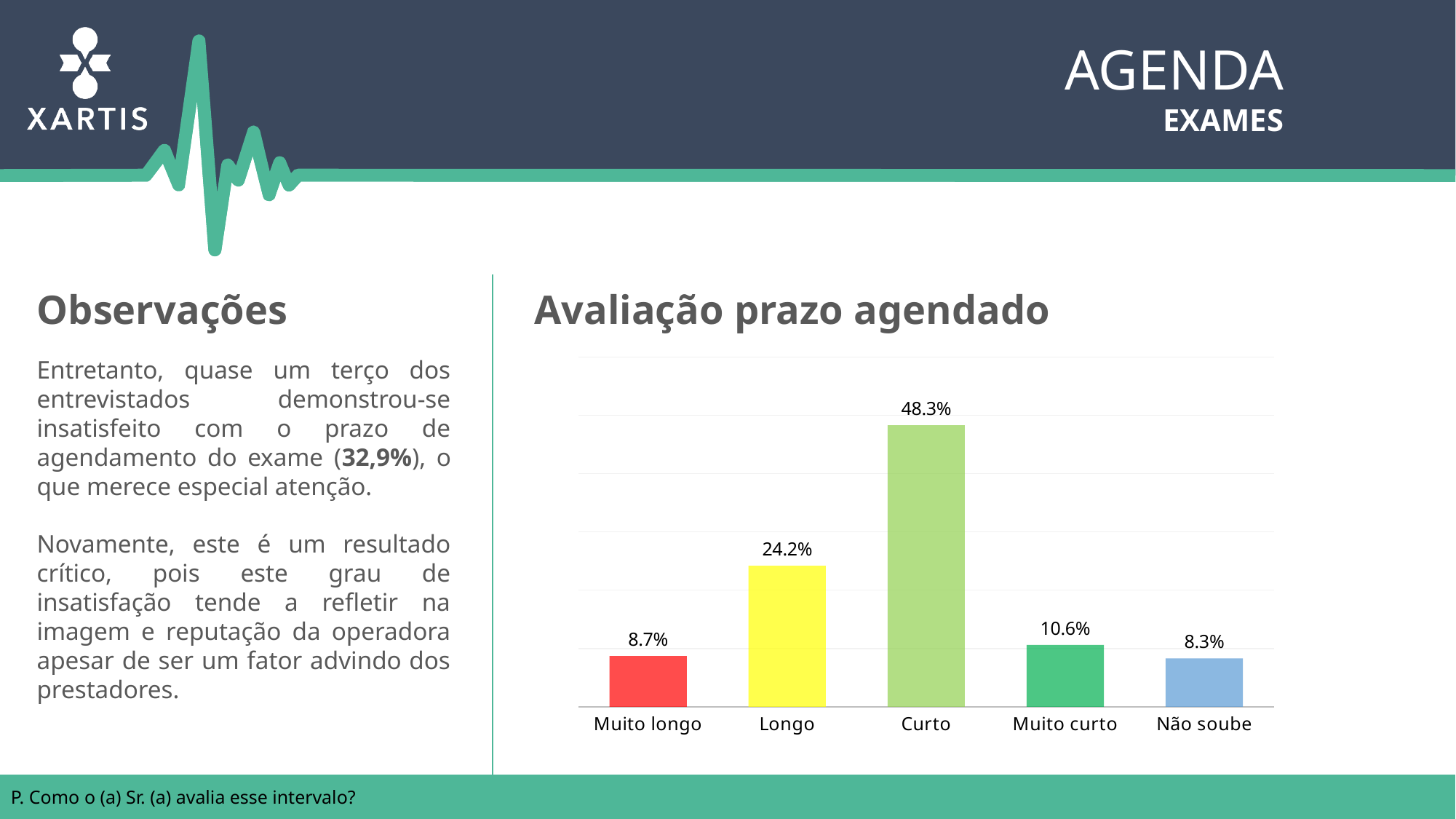
What is the difference between the values for Muito curto and Muito longo? 1.9% What is the value for Muito longo? 8.7% Which category has the highest value? Curto Which category has the lowest value? Não soube What is the value for Longo? 24.2% What is the value for Não soube? 8.3% What is the value for Curto? 48.3% What is the title of the chart? Avaliação prazo agendado What is the difference between the values for Curto and Longo? 24.1% What kind of chart is shown on the slide? Bar chart How many categories are shown in the chart? 5 Which is larger, the value for Longo or the value for Muito curto? Longo